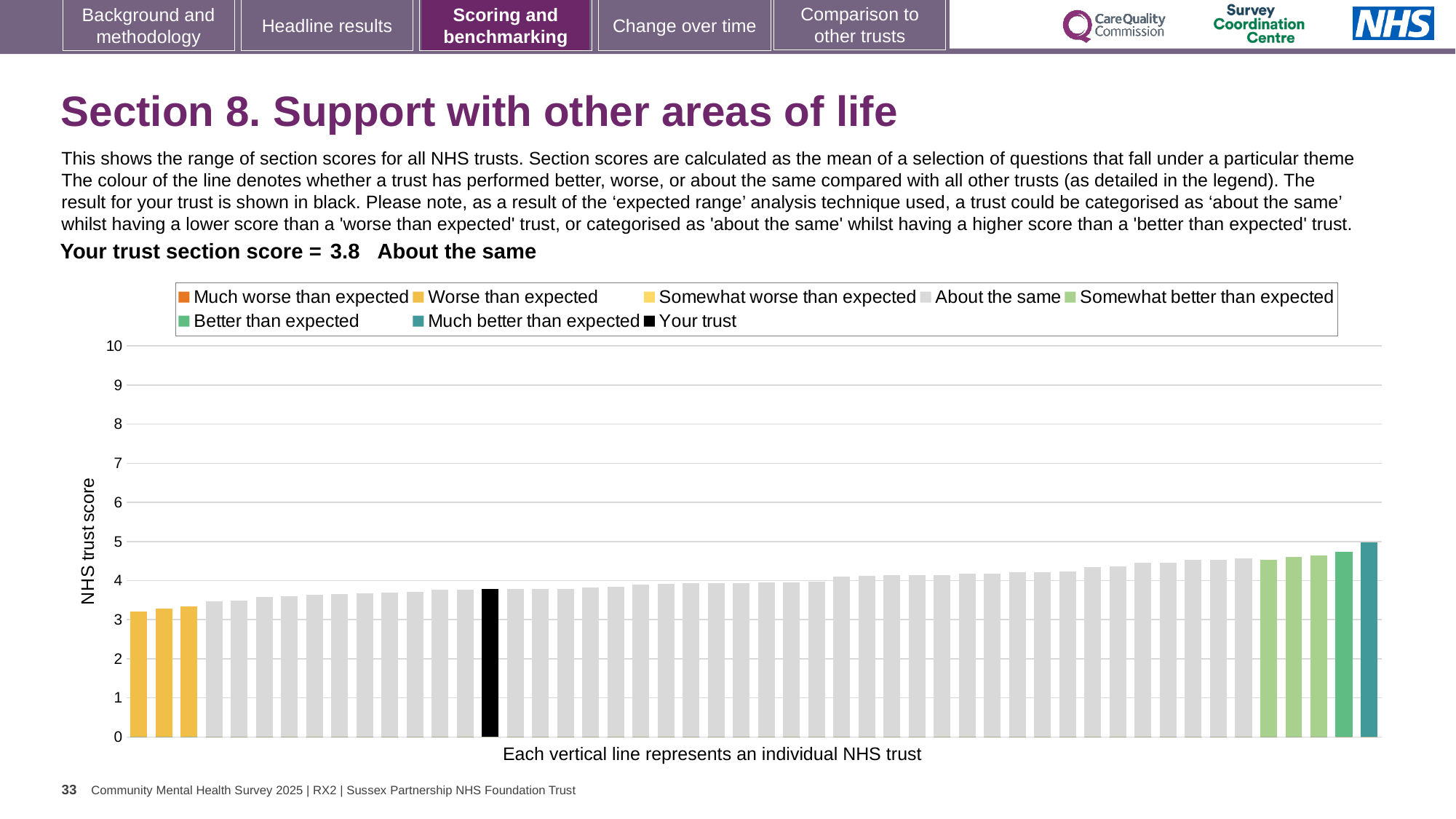
Is the value of the tallest bar greater or less than 4? greater What is the label on the y axis of the chart? NHS trust score What kind of chart is shown on the slide? bar chart Is the value for your trust (the black bar) greater or less than 4? less What is the section score for your trust shown on the slide? 3.8 Is the value for your trust (the black bar) greater or less than 3? greater Do the bar values rise or fall from left to right along the x axis? rise Which performance category is your trust placed in for this section? About the same How many bars are coloured in the 'Worse than expected' colour (yellow) at the left of the chart? 3 How many entries does the chart legend list? 8 Which legend category does the tallest bar (the teal bar at the far right) belong to? Much better than expected